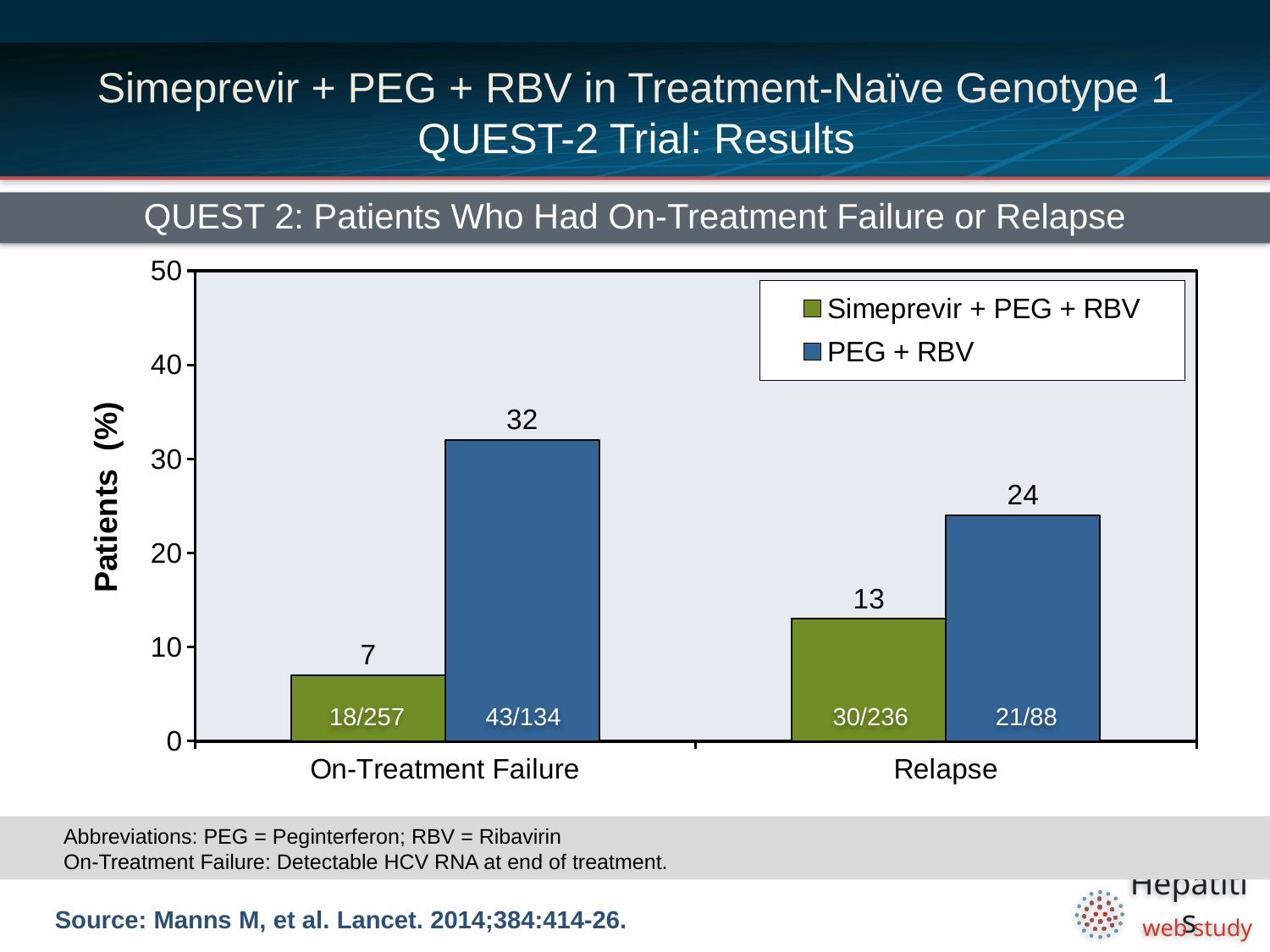
What percentage of patients in the PEG + RBV group had On-Treatment Failure? 32 Which group has the higher On-Treatment Failure rate, Simeprevir + PEG + RBV or PEG + RBV? PEG + RBV What fraction is printed inside the Simeprevir + PEG + RBV bar for Relapse? 30/236 Which bar on the chart has the lowest value? Simeprevir + PEG + RBV, On-Treatment Failure Which bar on the chart has the highest value? PEG + RBV, On-Treatment Failure What type of chart is shown on the slide? Bar chart What is the difference in On-Treatment Failure rate between the PEG + RBV group and the Simeprevir + PEG + RBV group? 25 What is the difference in Relapse rate between the PEG + RBV group and the Simeprevir + PEG + RBV group? 11 How many series does the legend list? 2 What percentage of patients in the PEG + RBV group had Relapse? 24 What percentage of patients in the Simeprevir + PEG + RBV group had On-Treatment Failure? 7 How many categories are shown on the x axis? 2